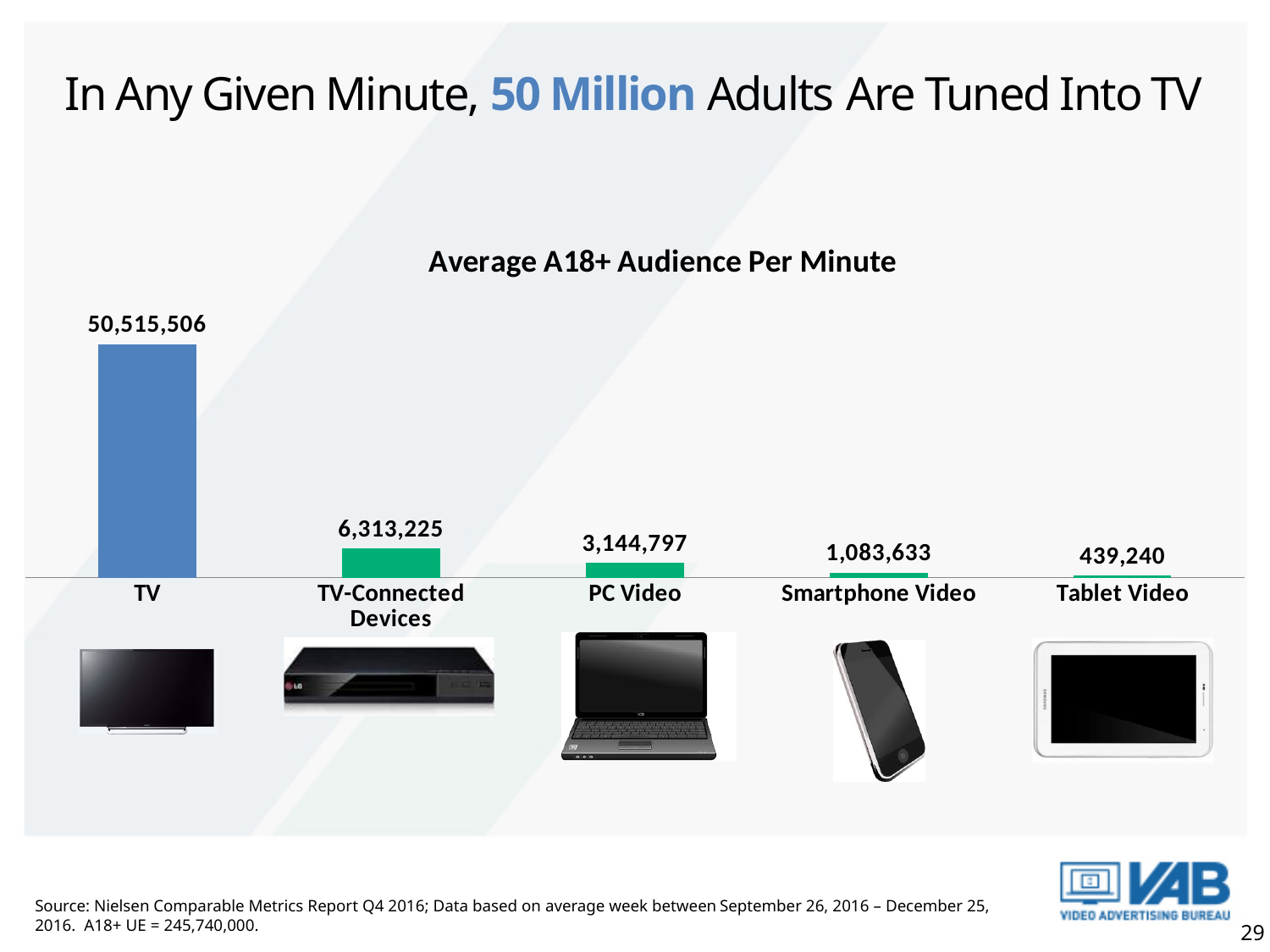
What is the average A18+ audience per minute for Tablet Video? 439,240 How many categories are shown in the chart? 5 What is the average A18+ audience per minute for Smartphone Video? 1,083,633 Do the values rise or fall moving from left to right across the chart? Fall What is the average A18+ audience per minute for TV? 50,515,506 Which category has the lowest average A18+ audience per minute? Tablet Video What is the average A18+ audience per minute for TV-Connected Devices? 6,313,225 What is the difference between the TV audience and the TV-Connected Devices audience? 44,202,281 What is the difference between the Smartphone Video audience and the Tablet Video audience? 644,393 Which has a larger average audience per minute, PC Video or Smartphone Video? PC Video What is the average A18+ audience per minute for PC Video? 3,144,797 Which category has the highest average A18+ audience per minute? TV